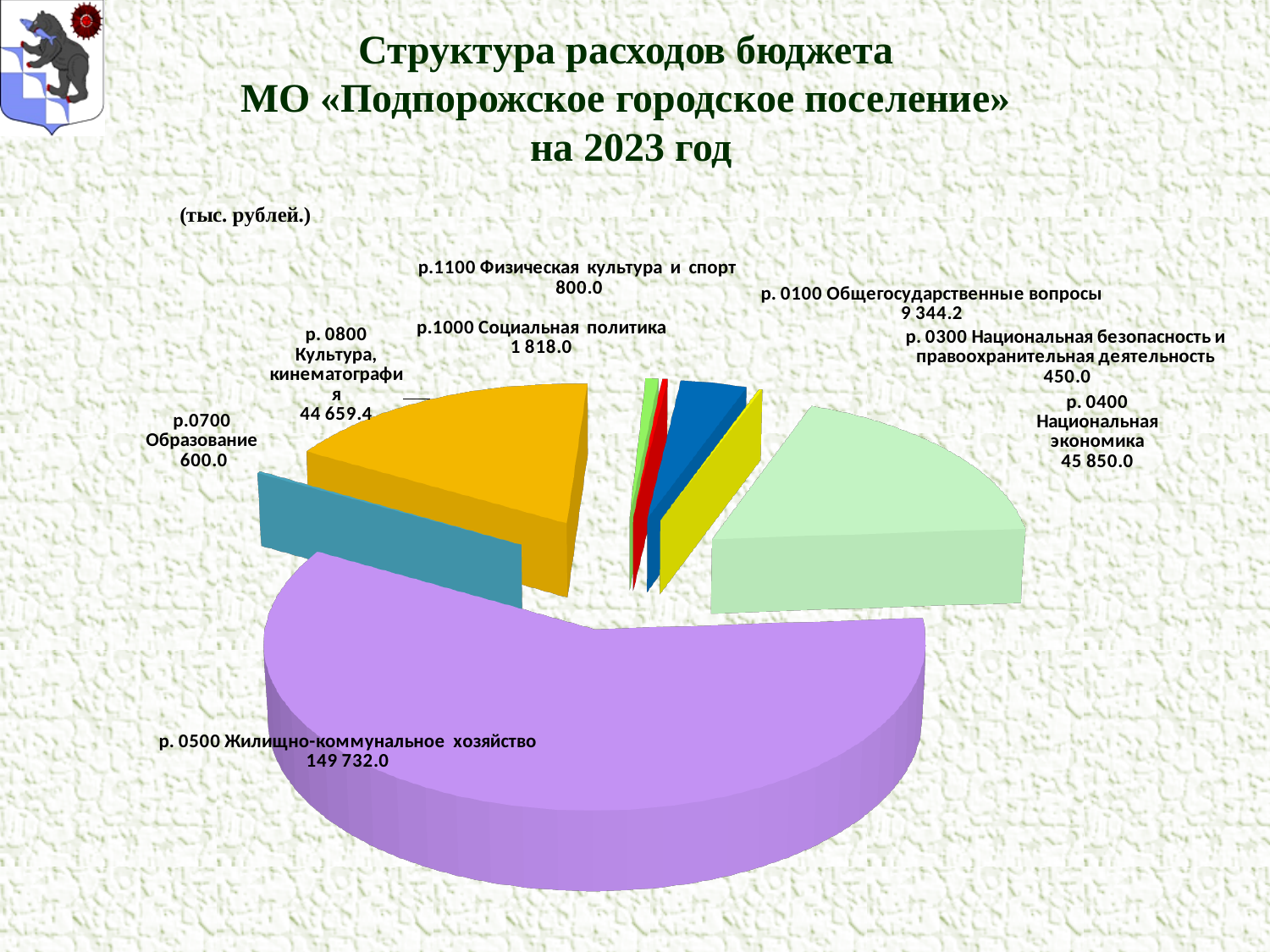
What is the value for р. 0500 Жилищно-коммунальное хозяйство? 149 732.0 In what units are the values on the chart given? тыс. рублей What is the value for р. 0100 Общегосударственные вопросы? 9 344.2 What is the value for р. 0400 Национальная экономика? 45 850.0 What is the value for р. 0800 Культура, кинематография? 44 659.4 What is the difference between р. 0400 Национальная экономика and р. 0800 Культура, кинематография? 1 190.6 Which category has the largest value? р. 0500 Жилищно-коммунальное хозяйство How many categories are shown in the pie chart? 8 Which category has the smallest value? р. 0300 Национальная безопасность и правоохранительная деятельность What kind of chart is shown on the slide? pie chart What is the value for р.1000 Социальная политика? 1 818.0 Which is larger: р.1100 Физическая культура и спорт or р.0700 Образование? р.1100 Физическая культура и спорт